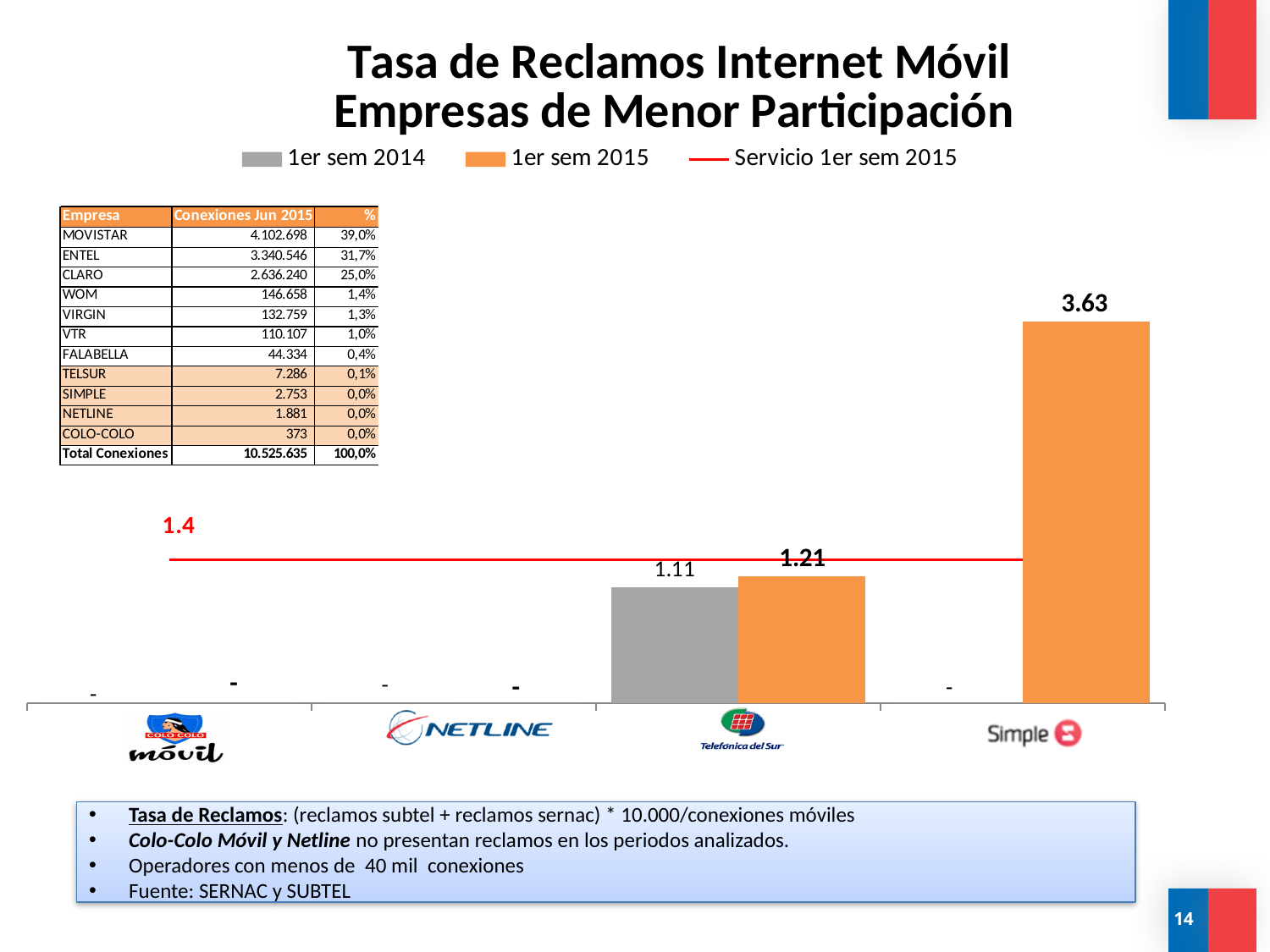
How many series does the chart legend list? 3 What value is shown for the Servicio 1er sem 2015 line? 1.4 Which company has the highest 1er sem 2015 value? Simple What is the difference between the 1er sem 2015 value for Simple and the 1er sem 2015 value for Telefónica del Sur? 2.42 Is the 1er sem 2015 value for Telefónica del Sur greater or less than the Servicio 1er sem 2015 line value of 1.4? less What is the value of the 1er sem 2014 bar for Telefónica del Sur? 1.11 What is the value of the 1er sem 2015 bar for Telefónica del Sur? 1.21 What is the difference between the 1er sem 2015 and 1er sem 2014 values for Telefónica del Sur? 0.10 Which is larger for Telefónica del Sur: the 1er sem 2014 value or the 1er sem 2015 value? 1er sem 2015 What is the value of the 1er sem 2015 bar for Simple? 3.63 How many companies are shown on the x axis of the chart? 4 What kind of chart is shown on the slide? combination bar and line chart